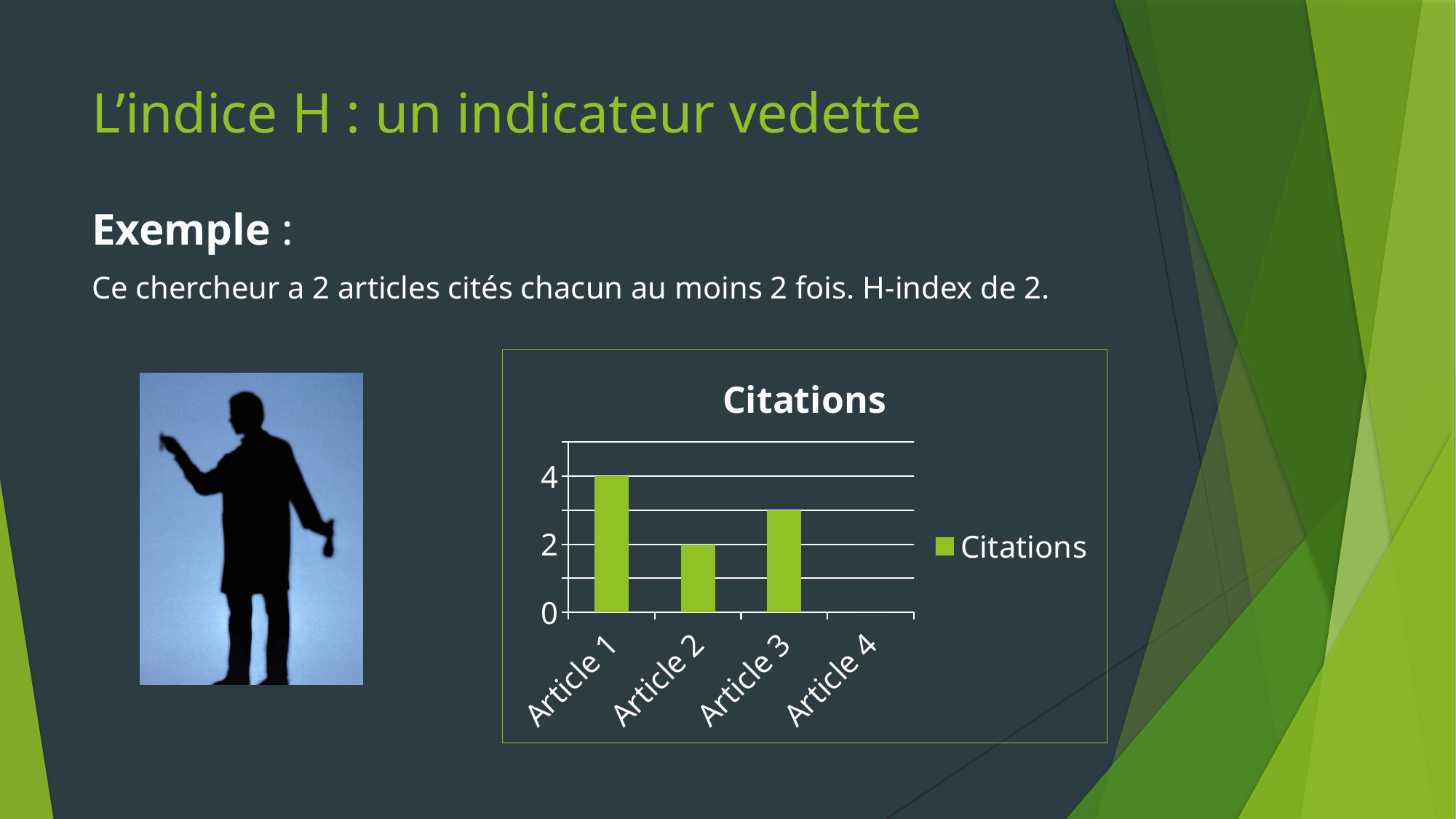
What is the value for Article 1? 4 What is the title of the chart? Citations What type of chart is shown on the slide? bar chart What is the difference between the values for Article 1 and Article 2? 2 Which is larger, the value for Article 1 or the value for Article 3? Article 1 How many categories are shown on the x axis of the chart? 4 What is the value for Article 2? 2 Which article has the highest number of citations? Article 1 Which article has the lowest number of citations? Article 4 What colour are the bars in the chart? green How many series does the chart legend list? 1 Is the value for Article 3 greater or less than 2? greater